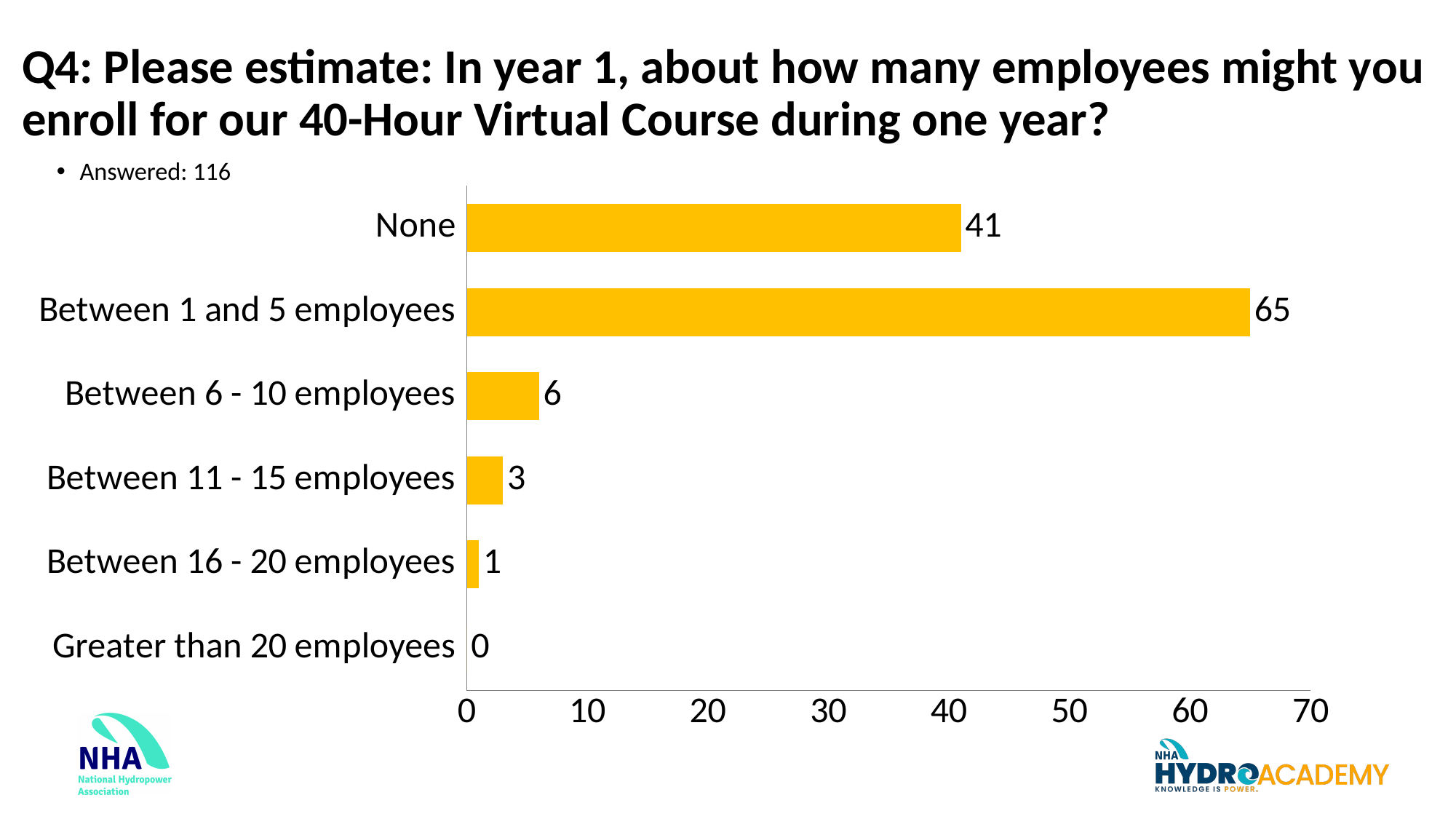
What is the value for "Between 6 - 10 employees"? 6 Which is larger, the value for "Between 11 - 15 employees" or "Between 16 - 20 employees"? Between 11 - 15 employees Which category has the lowest value? Greater than 20 employees What is the value for "None"? 41 What is the difference between the values for "Between 1 and 5 employees" and "None"? 24 How many categories are shown in the chart? 6 What is the value for "Between 1 and 5 employees"? 65 What is the value for "Greater than 20 employees"? 0 How many people answered the question, according to the slide? 116 Which category has the highest value? Between 1 and 5 employees What kind of chart is shown on the slide? bar chart Is the value for "None" greater or less than 40? greater